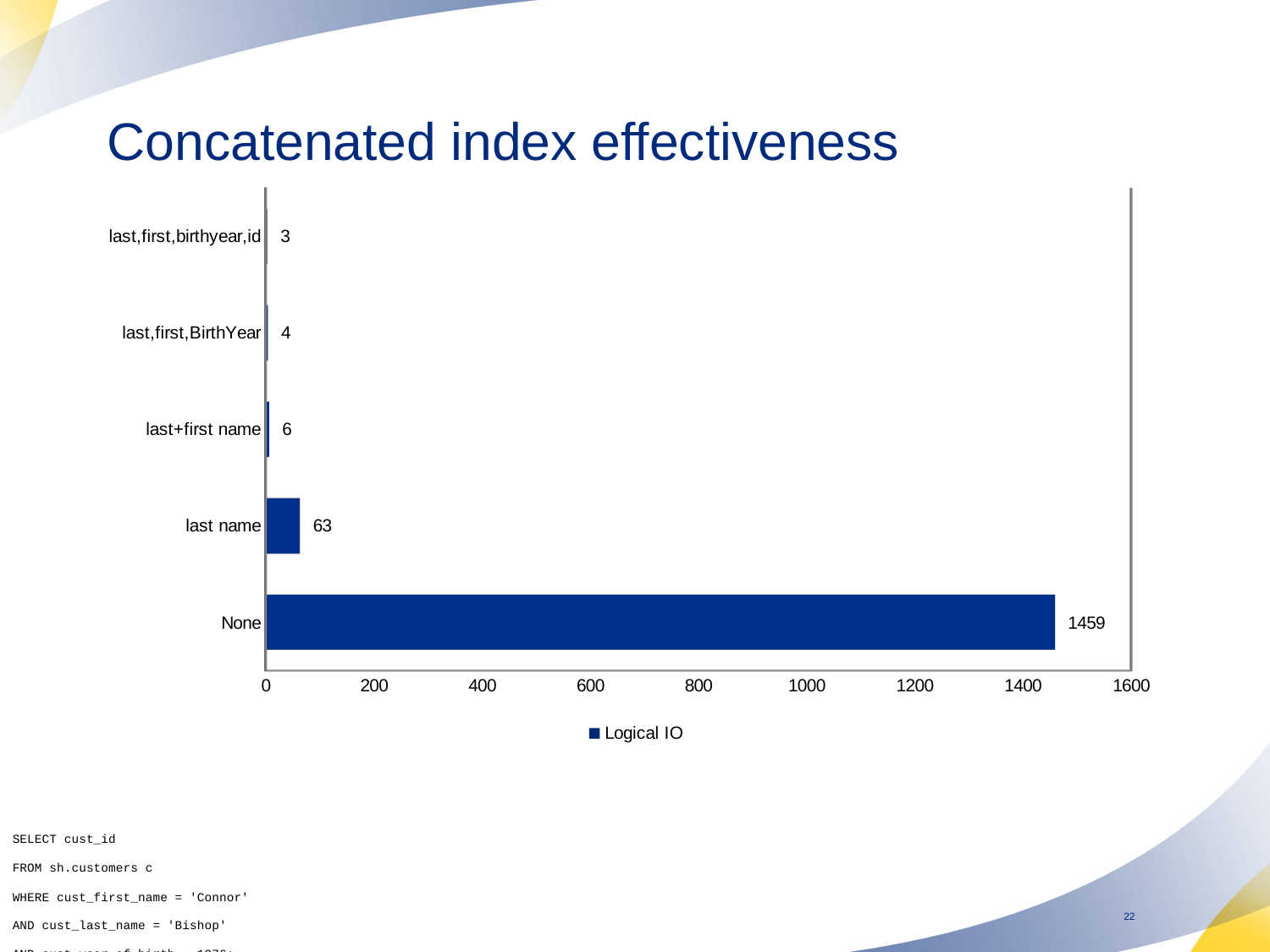
What is the Logical IO value for 'last,first,birthyear,id'? 3 How many categories are shown on the chart? 5 What is the Logical IO value for the 'None' index? 1459 Which has a larger Logical IO value, 'last name' or 'last+first name'? last name What is the Logical IO value for 'last,first,BirthYear'? 4 Which category has the lowest Logical IO? last,first,birthyear,id Which category has the highest Logical IO? None What is the Logical IO value for 'last+first name'? 6 What is the difference in Logical IO between 'None' and 'last name'? 1396 What is the Logical IO value for 'last name'? 63 What type of chart is shown on the slide? Bar chart What series does the legend list? Logical IO